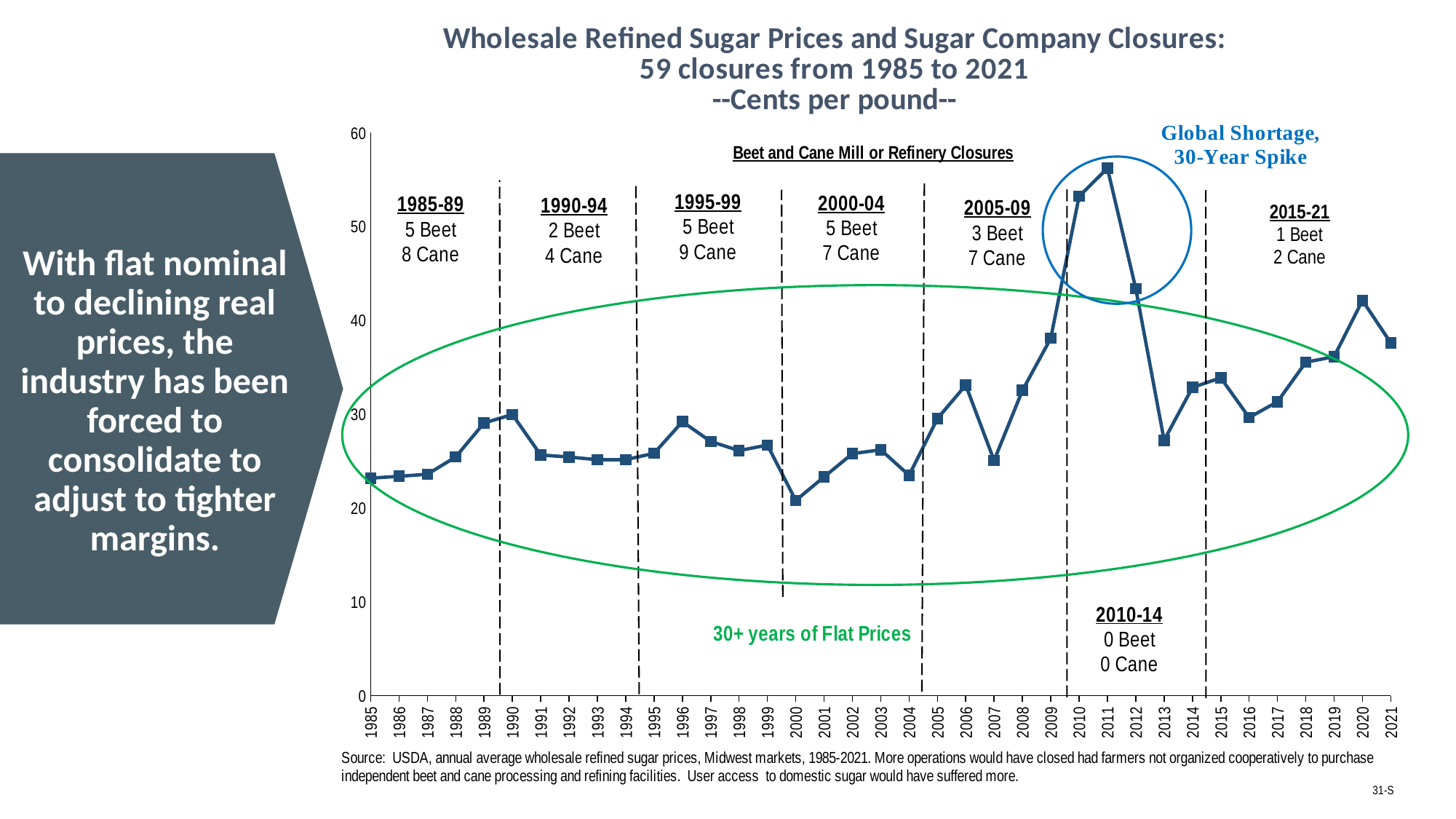
How many years are plotted along the x axis of the chart? 37 What kind of chart is shown on the slide? line chart Is the value for 2011 greater or less than 50? greater What is the title of the chart? Wholesale Refined Sugar Prices and Sugar Company Closures: 59 closures from 1985 to 2021 --Cents per pound-- Is the value for 2020 greater or less than 40? greater Which year has the higher price, 2011 or 2012? 2011 Do prices rise or fall from 2011 to 2013? fall What does the blue circle annotation on the chart label the 2010-2012 peak as? Global Shortage, 30-Year Spike Is the value for 2000 greater or less than 30? less In which year is the wholesale refined sugar price highest? 2011 In which year is the wholesale refined sugar price lowest? 2000